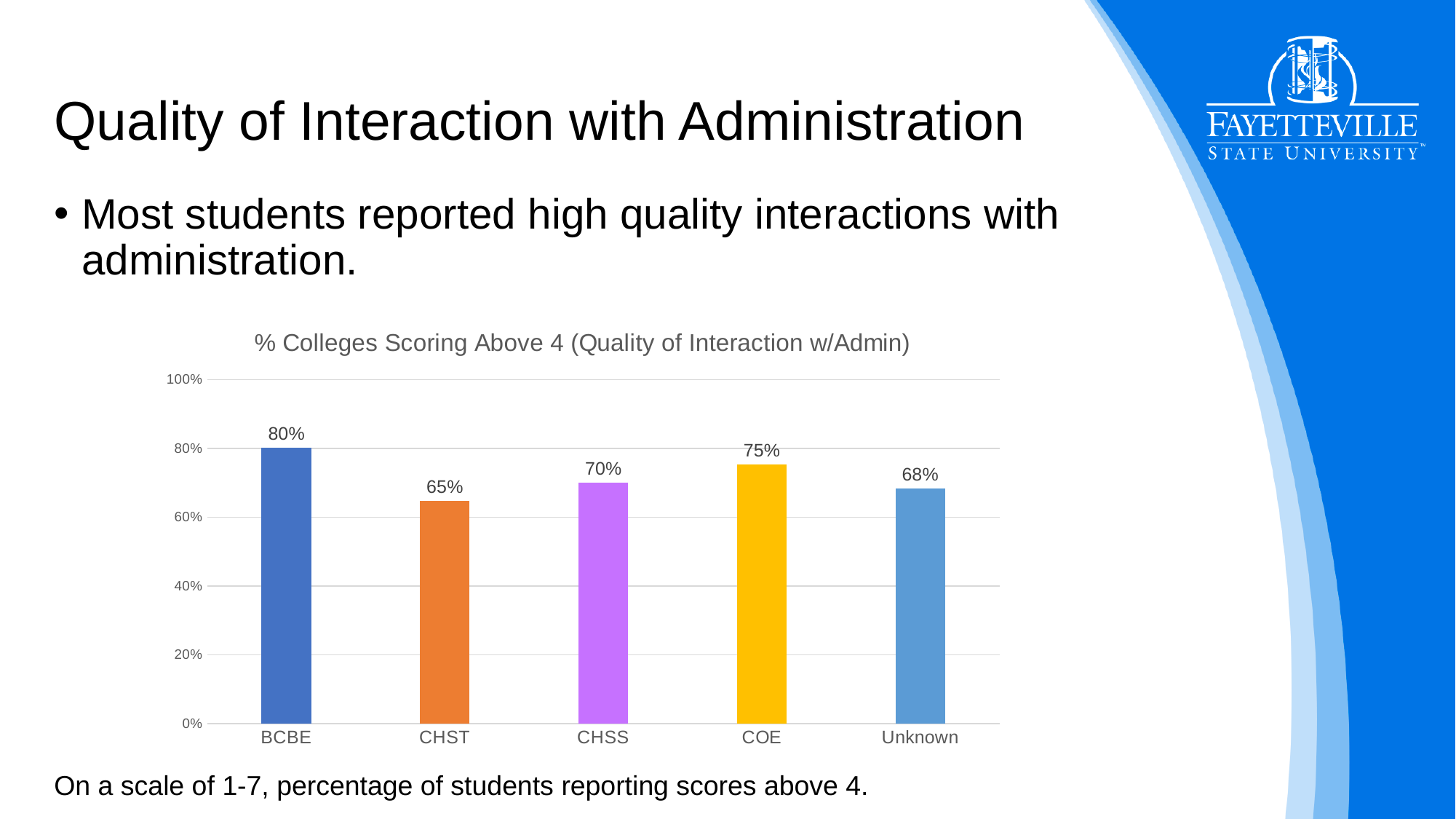
Which category has the lowest value? CHST What kind of chart is shown on the slide? bar chart How many categories are shown on the x axis? 5 Is the value for CHSS greater or less than 60%? greater What is the value for Unknown? 68% What is the value for CHST? 65% What is the value for BCBE? 80% What is the title of the chart? % Colleges Scoring Above 4 (Quality of Interaction w/Admin) Which is larger, the value for COE or the value for Unknown? COE Which category has the highest value? BCBE What is the difference between the values for COE and CHSS? 5% What is the difference between the values for BCBE and CHST? 15%